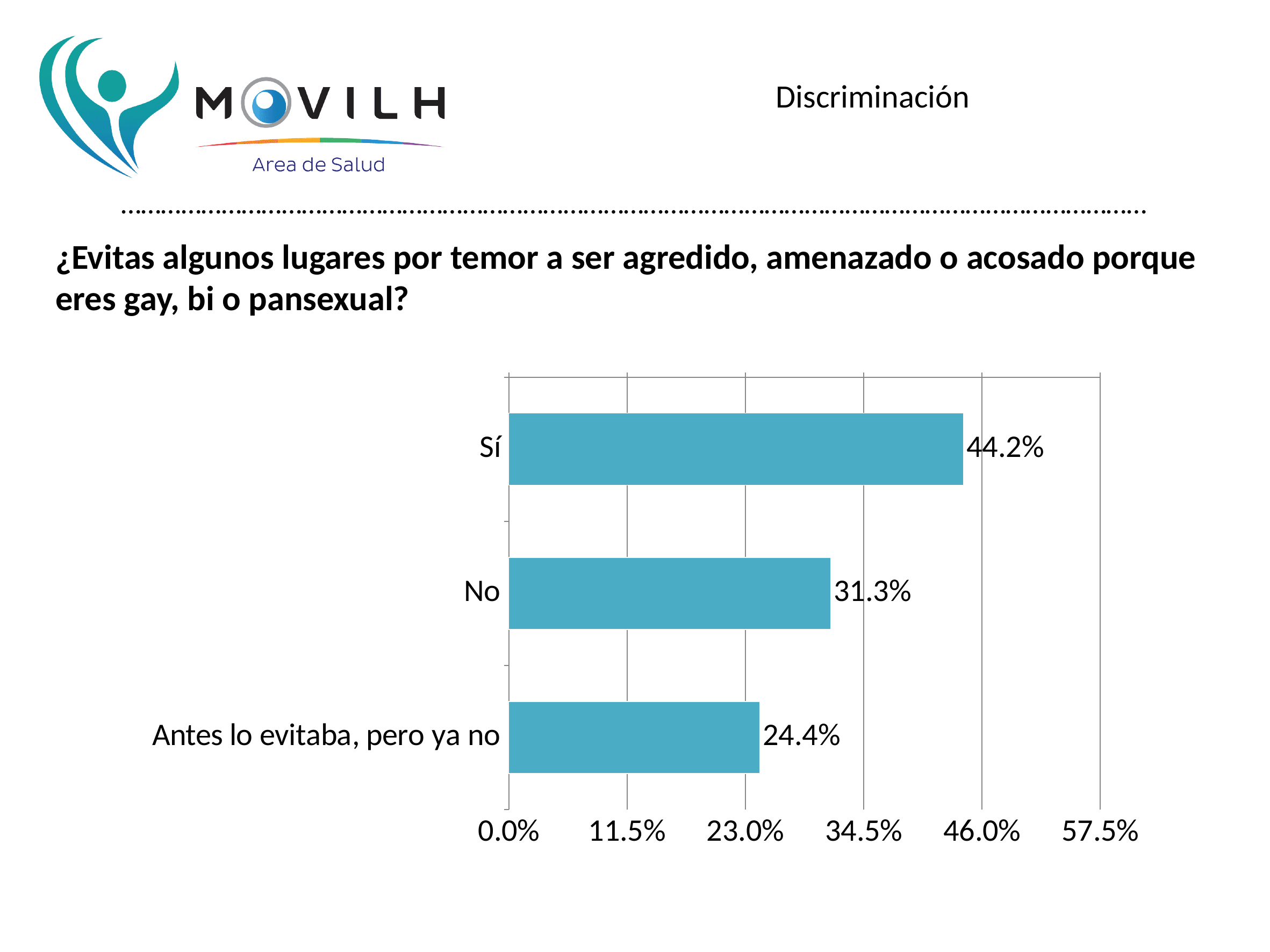
Is the value for "Sí" greater or less than 34.5%? greater How many categories are shown in the chart? 3 What is the difference between the values for "No" and "Antes lo evitaba, pero ya no"? 6.9% Which is larger, the value for "No" or the value for "Antes lo evitaba, pero ya no"? No Which category has the lowest value? Antes lo evitaba, pero ya no What kind of chart is shown on the slide? bar chart What is the value for "Antes lo evitaba, pero ya no"? 24.4% Which category has the highest value? Sí What is the highest value shown on the x axis? 57.5% What is the difference between the values for "Sí" and "No"? 12.9% What is the value for "No"? 31.3% What is the value for "Sí"? 44.2%